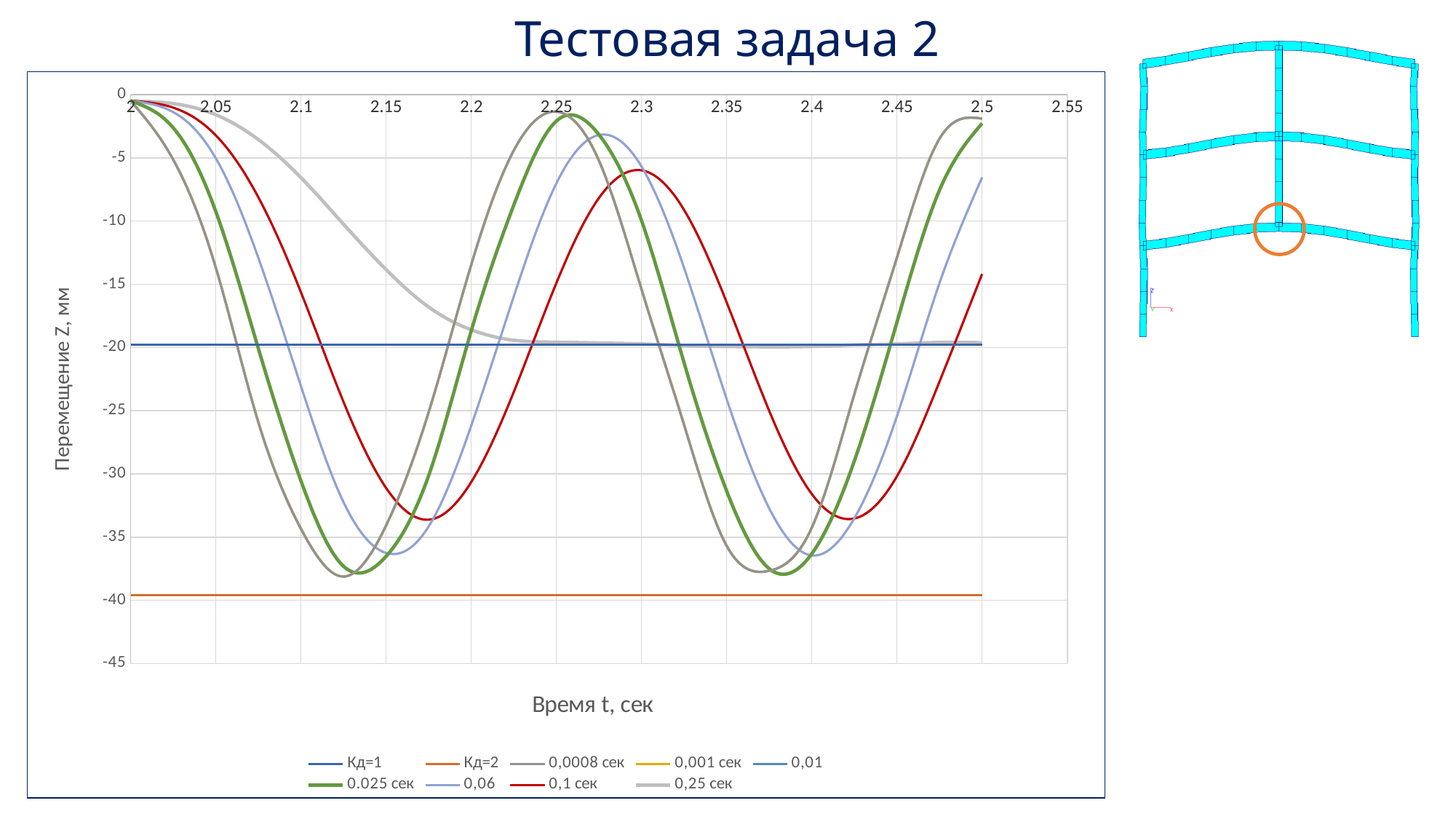
Is the lowest value reached by the 0,1 сек series greater or less than -35? greater What is the title of the vertical axis of the chart? Перемещение Z, мм Does the 0,25 сек series rise or fall between t = 2 and t = 2.25? fall Which series has the lowest value on the chart? Кд=2 Which series has the larger value at t = 2.3: Кд=1 or Кд=2? Кд=1 Is the value of the Кд=2 series greater or less than -35? less Is the lowest value reached by the 0.025 сек series greater or less than -35? less How many series does the chart legend list? 9 What kind of chart is shown on the slide? line chart Which series has the larger value at t = 2.15: 0,25 сек or 0,06? 0,25 сек What is the title of the horizontal axis of the chart? Время t, сек